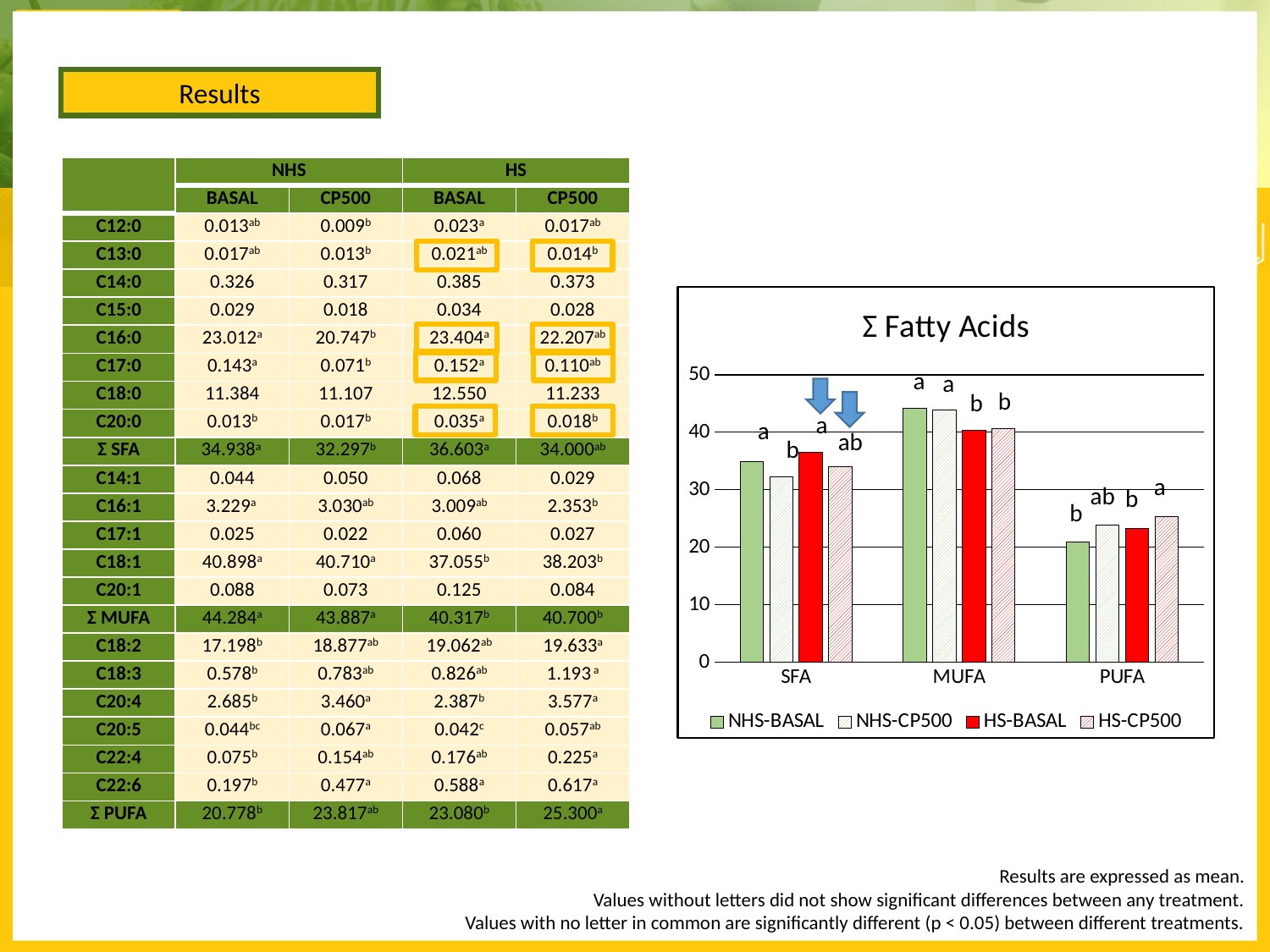
How many series does the legend of the Σ Fatty Acids chart list? 4 In the Σ Fatty Acids chart, is the HS-BASAL value for SFA greater or less than 30? greater In the Σ Fatty Acids chart, which category has the lowest NHS-BASAL bar? PUFA In the Σ Fatty Acids chart, is the NHS-BASAL value for MUFA greater or less than 40? greater In the Σ Fatty Acids chart, for PUFA, which is larger: the NHS-BASAL bar or the HS-CP500 bar? HS-CP500 In the Σ Fatty Acids chart, for MUFA, which is larger: the NHS-BASAL bar or the HS-BASAL bar? NHS-BASAL In the Σ Fatty Acids chart, is the NHS-BASAL value for PUFA greater or less than 30? less Which series are listed in the legend of the Σ Fatty Acids chart? NHS-BASAL, NHS-CP500, HS-BASAL, HS-CP500 How many categories are shown on the x axis of the Σ Fatty Acids chart? 3 In the Σ Fatty Acids chart, which category has the highest NHS-BASAL bar? MUFA What is the title of the chart on the slide? Σ Fatty Acids What type of chart is shown on the slide? bar chart